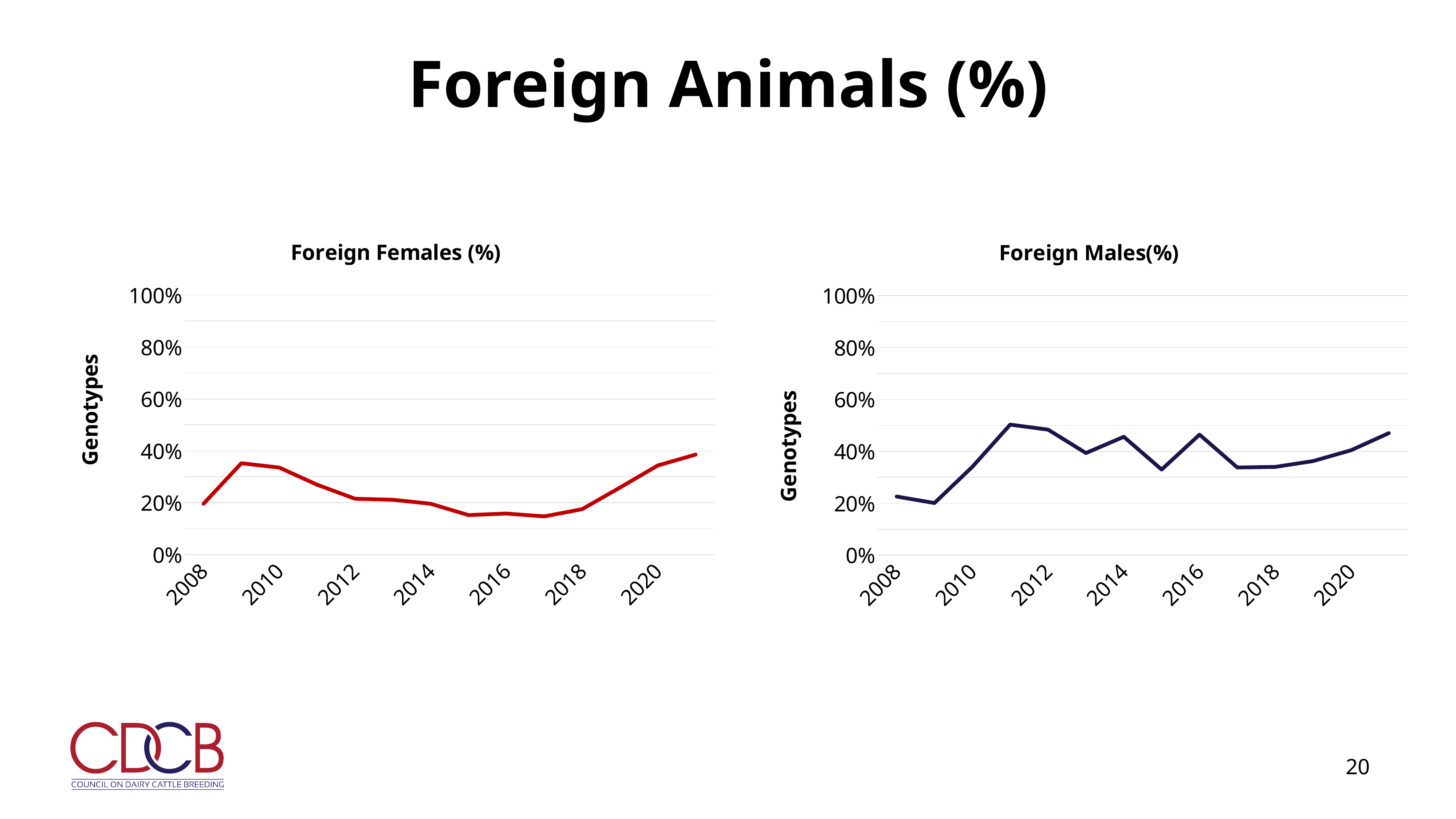
What kind of chart is the Foreign Females (%) chart? line chart What is the y-axis label on the Foreign Males(%) chart? Genotypes In the Foreign Males(%) chart, do the values rise or fall from 2018 to 2021? rise In the Foreign Females (%) chart, is the value for 2017 greater or less than 20%? less In the Foreign Females (%) chart, which year has the highest value? 2021 In the Foreign Females (%) chart, which is larger, the value for 2009 or the value for 2017? 2009 In the Foreign Females (%) chart, is the value for 2009 greater or less than 20%? greater In the Foreign Males(%) chart, which is larger, the value for 2011 or the value for 2008? 2011 In the Foreign Females (%) chart, do the values rise or fall from 2017 to 2021? rise In the Foreign Males(%) chart, is the value for 2011 greater or less than 40%? greater What kind of chart is the Foreign Males(%) chart? line chart